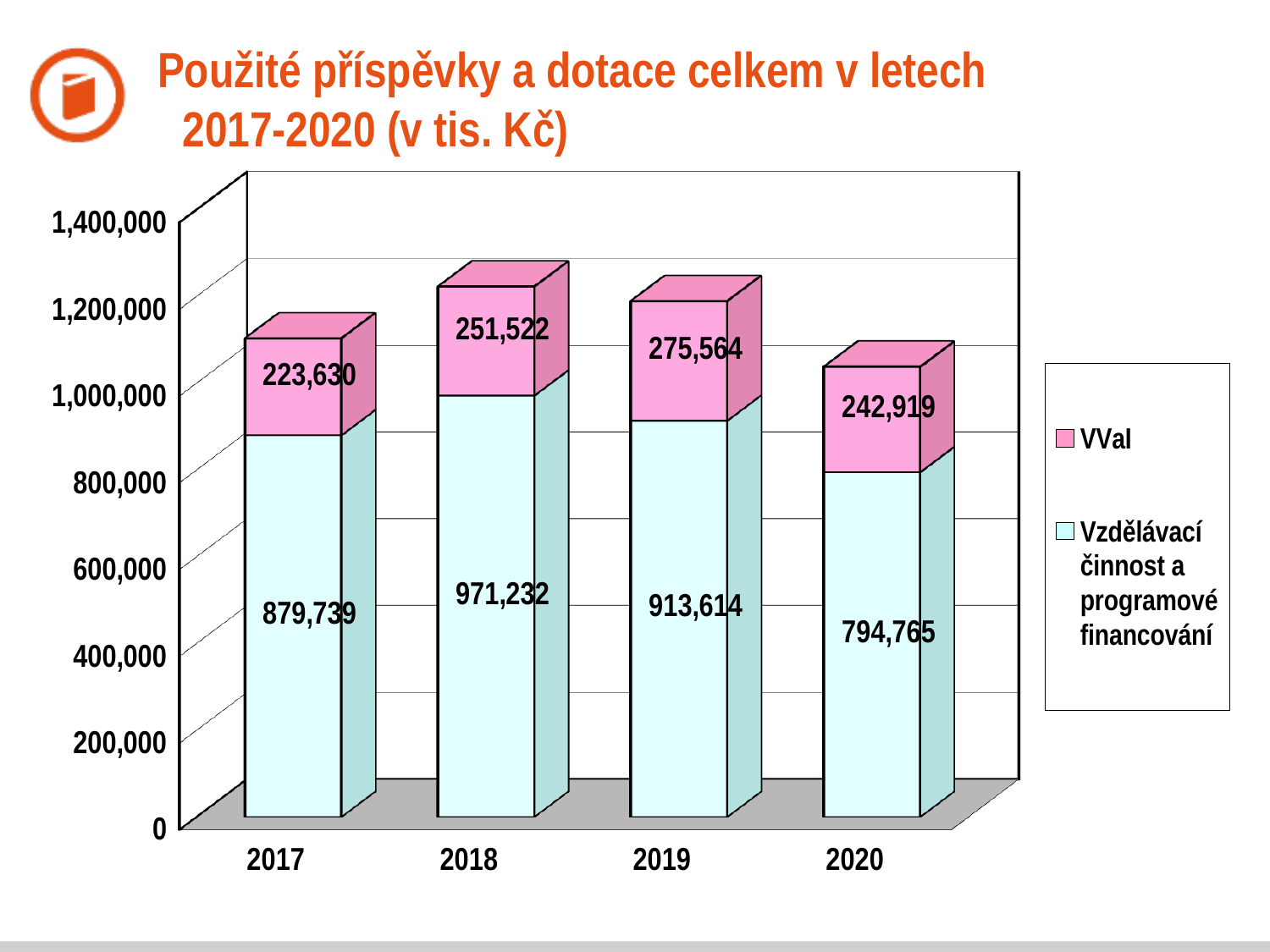
What is the value for VVaI in 2019? 275,564 What is the difference between the Vzdělávací činnost a programové financování values for 2018 and 2017? 91,493 In which year is the value for Vzdělávací činnost a programové financování highest? 2018 What is the value for VVaI in 2017? 223,630 In which year is the value for VVaI lowest? 2017 Which is larger, the VVaI value for 2018 or for 2020? 2018 What is the total of the stacked bar for 2018? 1,222,754 How many years are shown on the x axis? 4 How many series does the legend list? 2 What type of chart is shown on the slide? stacked bar chart Which series is shown in pink? VVaI What is the value for Vzdělávací činnost a programové financování in 2020? 794,765